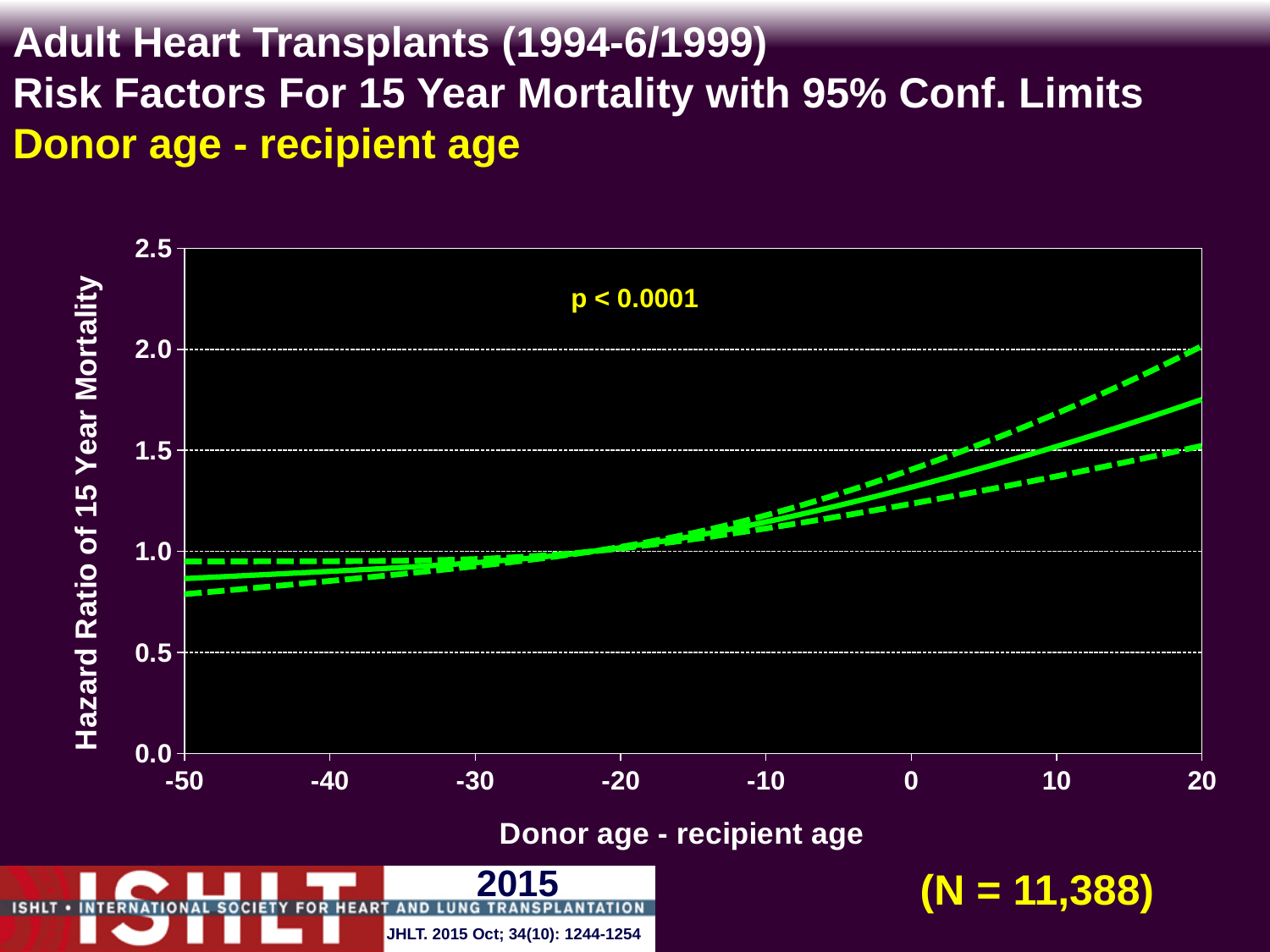
How many lines are plotted on the chart? 3 Is the hazard ratio (solid line) at a donor age - recipient age of -50 greater or less than 1.0? less Is the hazard ratio (solid line) at a donor age - recipient age of 0 greater or less than 1.0? greater How many tick labels are shown on the x axis? 8 What p-value is printed on the chart? p < 0.0001 Does the hazard ratio (solid line) rise or fall as donor age minus recipient age increases from -50 to 20? rise What kind of chart is shown on the slide? line chart Is the hazard ratio (solid line) at a donor age - recipient age of 0 greater or less than 1.5? less What is the label of the y axis? Hazard Ratio of 15 Year Mortality